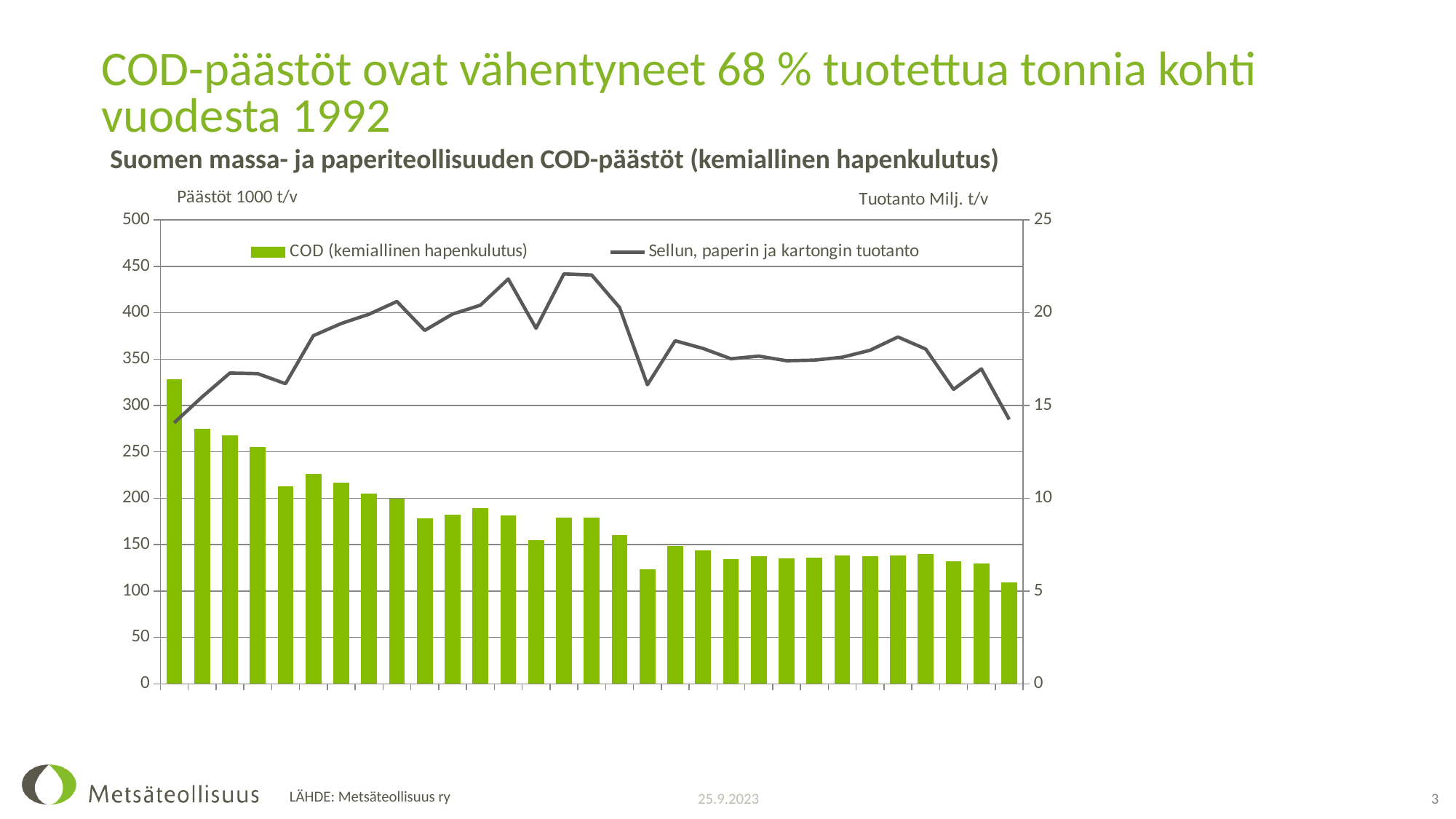
What is the title of the chart? Suomen massa- ja paperiteollisuuden COD-päästöt (kemiallinen hapenkulutus) What kind of chart is shown on the slide? A combined bar and line chart Do the COD emission bars generally rise or fall from left to right? Fall Which bar is the highest in the chart? The leftmost (first) bar Which bar is the lowest in the chart? The rightmost (last) bar Is the last point of the production line (right axis) greater or less than 15? less Is the highest point of the production line (right axis) greater or less than 20? greater Is the value of the leftmost COD bar greater or less than 300? greater How many series does the chart legend list? 2 Which series is shown as a line in the chart? Sellun, paperin ja kartongin tuotanto How many bars are plotted in the chart? 31